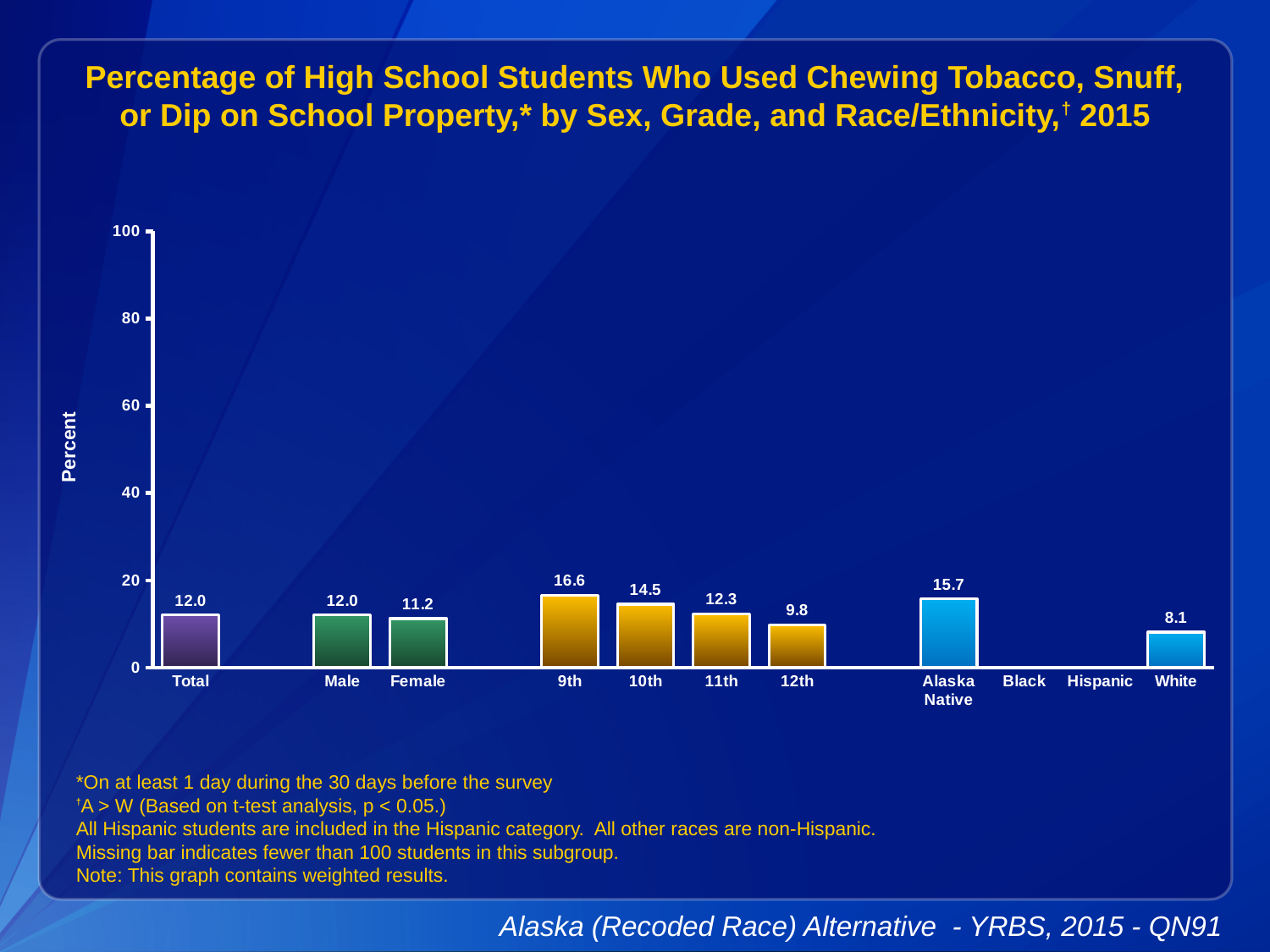
What kind of chart is shown? bar chart What is the value for 9th grade? 16.6 How many categories have a bar plotted? 9 What is the value for Alaska Native? 15.7 Which category with a bar has the lowest value? White What is the value for Female? 11.2 Which category has the highest value? 9th What is the difference between the values for 9th and 12th grade? 6.8 Which is larger, the value for Male or the value for Female? Male What is the value for Total? 12.0 Do the values fall or rise from 9th grade to 12th grade? fall Is the value for 10th grade greater or less than 20? less